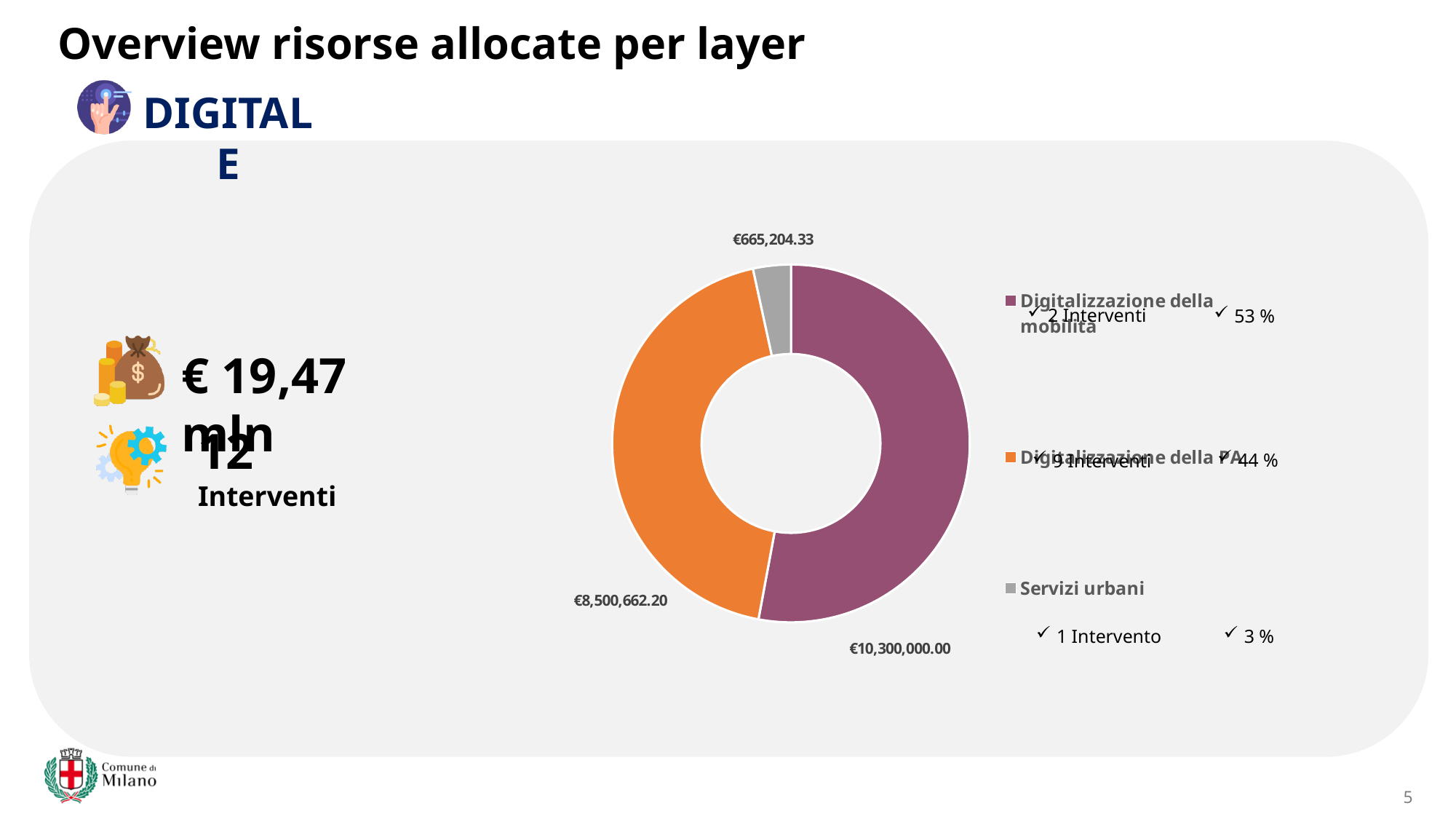
Which category has the smallest value? Servizi urbani Which category has the largest value? Digitalizzazione della mobilità What is the value for Digitalizzazione della PA? €8,500,662.20 What kind of chart is shown on the slide? Doughnut chart What share of the doughnut does Digitalizzazione della mobilità represent, as printed on the slide? 53 % Which is larger, Digitalizzazione della PA or Servizi urbani? Digitalizzazione della PA What is the value for Digitalizzazione della mobilità? €10,300,000.00 What colour is the Digitalizzazione della PA slice? Orange How many categories does the doughnut chart show? 3 What is the difference between Digitalizzazione della mobilità and Digitalizzazione della PA? €1,799,337.80 What share of the doughnut does Servizi urbani represent, as printed on the slide? 3 % What is the value for Servizi urbani? €665,204.33